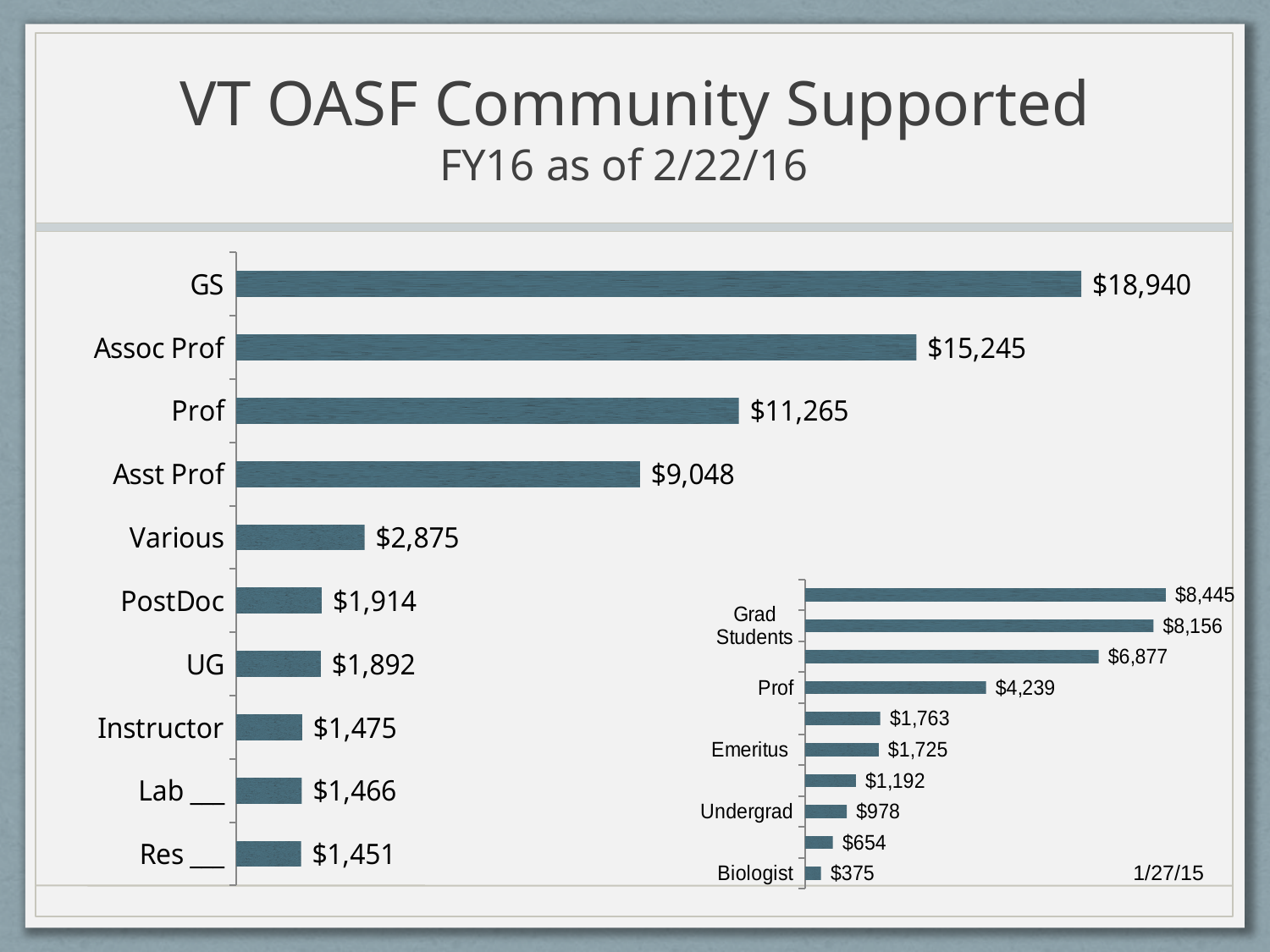
On the large bar chart on the left, how many categories are shown? 10 On the large bar chart on the left, what is the difference between the values for Assoc Prof and Prof? $3,980 On the small inset chart at the bottom right, what is the difference between the values for Emeritus and Undergrad? $747 What kind of chart is the large chart on the left? Bar chart On the large bar chart on the left, which is larger, the value for Various or the value for PostDoc? Various On the large bar chart on the left, what is the value for Asst Prof? $9,048 On the large bar chart on the left, which category has the lowest value? Res ___ On the small inset chart at the bottom right, what is the value for Biologist? $375 On the large bar chart on the left, what is the value for GS? $18,940 On the small inset chart at the bottom right, what is the value for Prof? $4,239 On the large bar chart on the left, what is the value for Instructor? $1,475 On the large bar chart on the left, which category has the highest value? GS